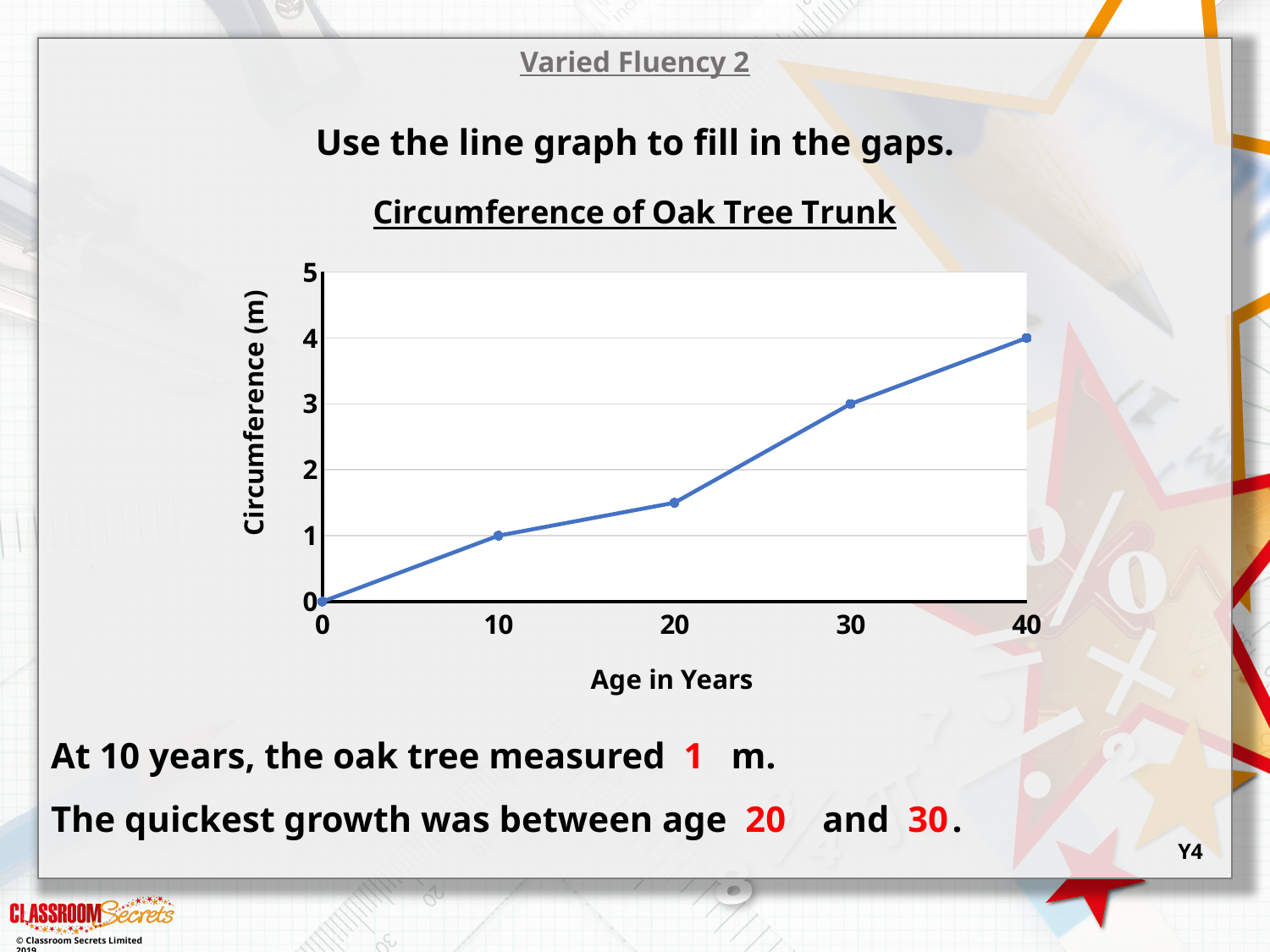
What type of chart is shown on the slide? line chart What is the circumference of the oak tree trunk at 30 years? 3 m At which age is the circumference of the oak tree trunk highest? 40 What is the circumference of the oak tree trunk at 40 years? 4 m What is the difference in circumference between age 30 and age 10? 2 m Which has the larger circumference, the tree at 30 years or at 10 years? 30 years Is the circumference at 20 years greater or less than 1 m? greater Does the circumference rise or fall as age increases along the x axis? rise According to the chart, what was the circumference of the oak tree trunk at 10 years? 1 m How many data points are plotted on the line? 5 Is the circumference at 20 years greater or less than 2 m? less What is the circumference of the oak tree trunk at age 0? 0 m